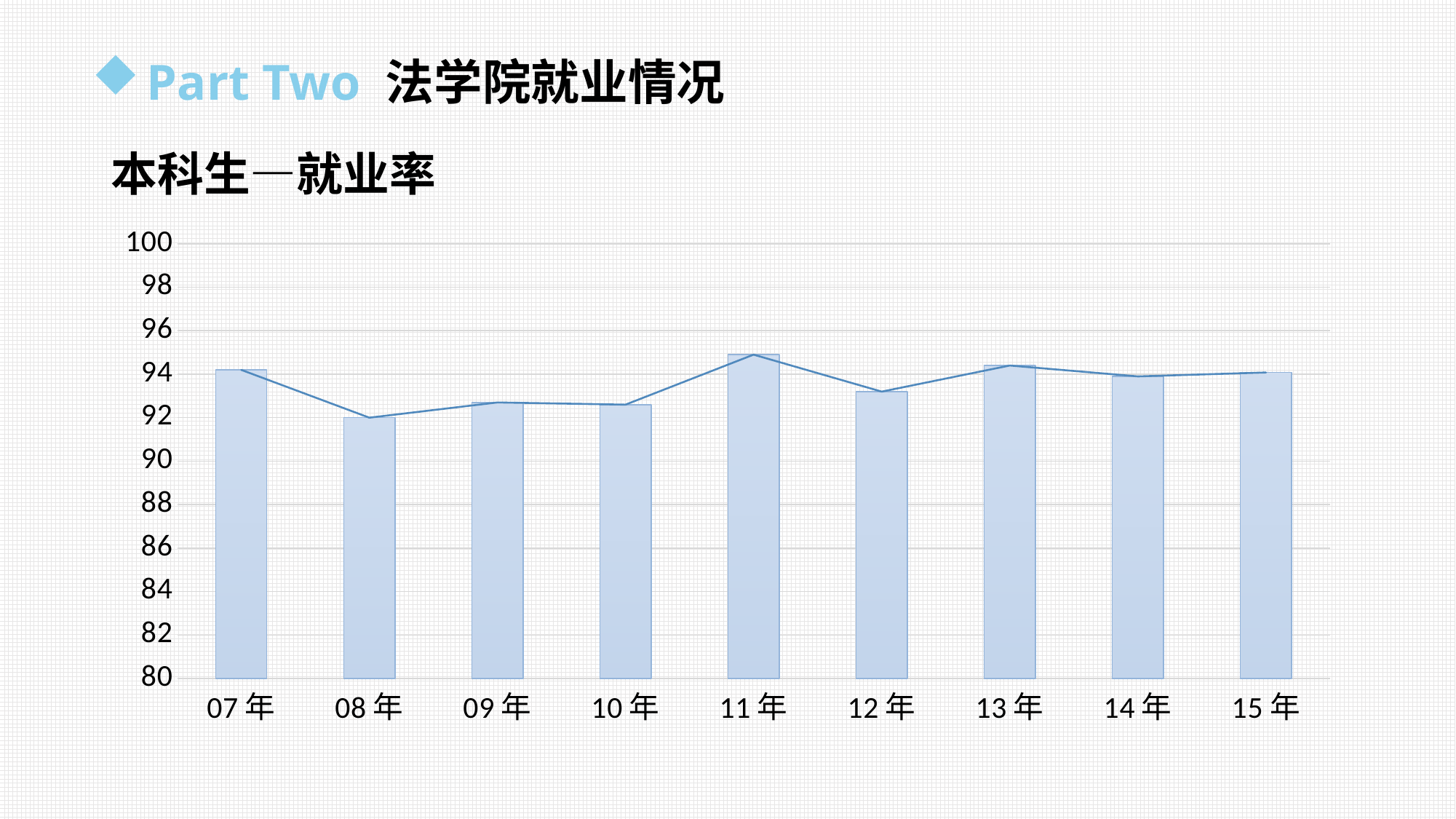
Is the value for 12年 greater or less than 92? greater Does the value rise or fall from 07年 to 08年? fall How many years are shown on the x axis of the chart? 9 Which year has the highest value in the chart? 11年 Which is larger, the value for 11年 or the value for 12年? 11年 Which year has the lowest value in the chart? 08年 Is the value for 09年 greater or less than 94? less What kind of chart is shown on the slide? combination bar and line chart Is the value for 08年 greater or less than 94? less Which is larger, the value for 07年 or the value for 08年? 07年 What is the title shown above the chart? 本科生—就业率